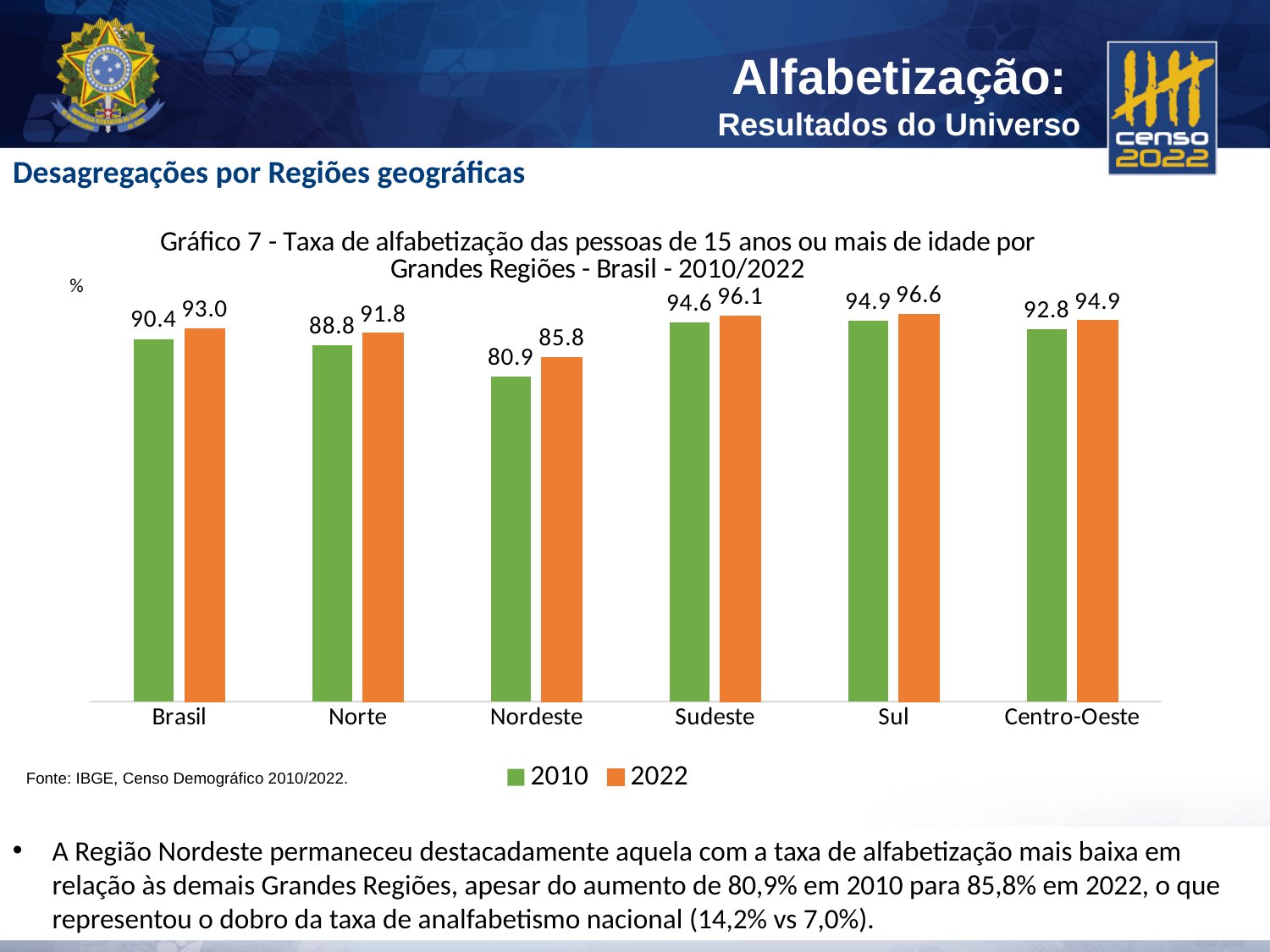
What is the literacy rate for Nordeste in 2022? 85.8 What is the difference between the 2022 values for Sul and Brasil? 3.6 How many regions (categories) are shown on the x axis? 6 What kind of chart is shown on the slide? Bar chart How many series does the legend list? 2 Which is larger: the 2010 value for Sudeste or the 2010 value for Centro-Oeste? Sudeste What is the value for Sul in 2022? 96.6 What is the literacy rate for Brasil in 2010? 90.4 Which category has the lowest literacy rate in 2010? Nordeste What is the difference between the 2022 and 2010 values for Nordeste? 4.9 Which region has the highest literacy rate in 2022? Sul Which colour represents the 2022 series in the chart? Orange